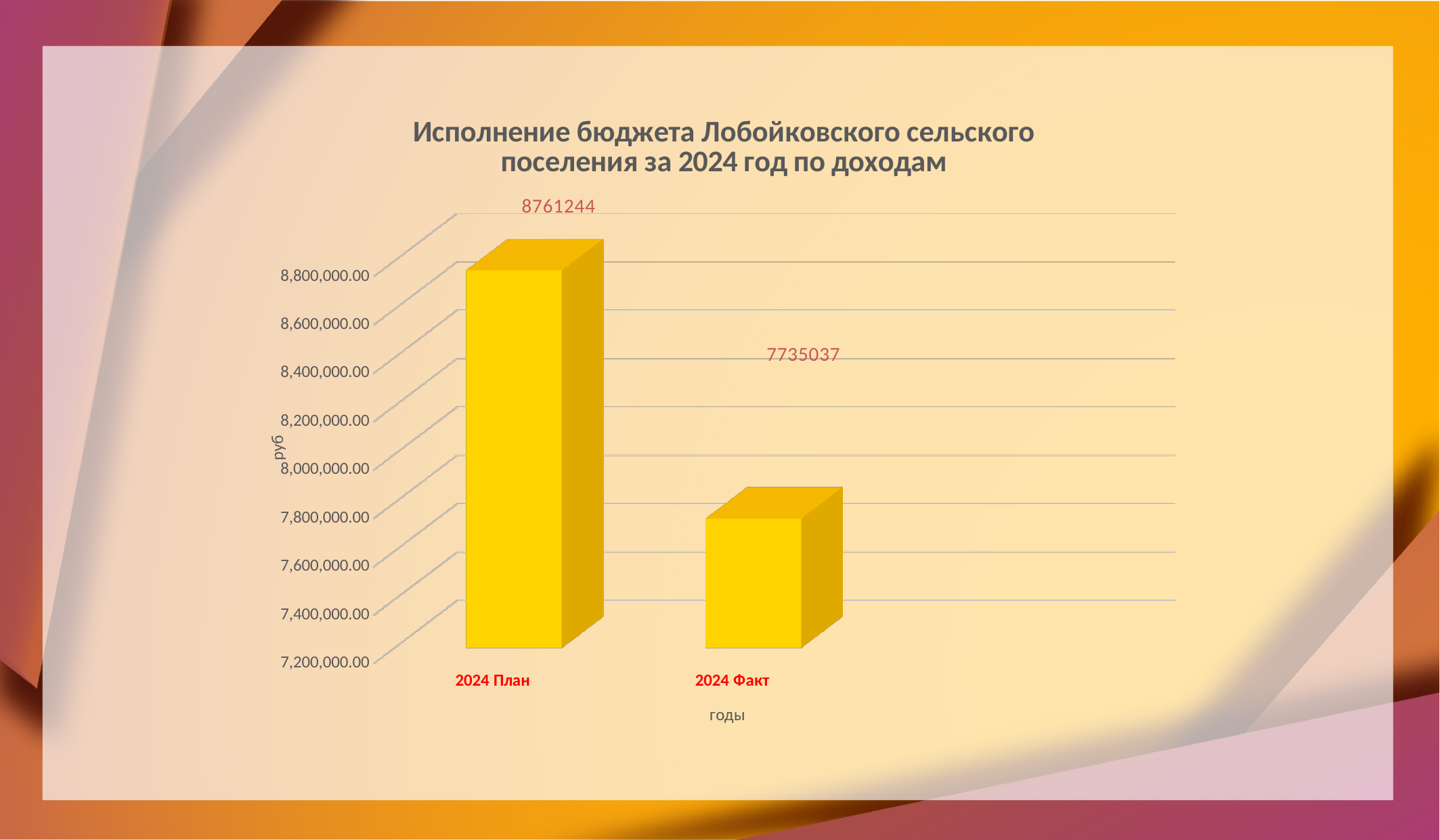
What is the value for 2024 Факт? 7735037 Is the value for 2024 Факт greater or less than 8,000,000.00? less What is the title of the chart? Исполнение бюджета Лобойковского сельского поселения за 2024 год по доходам What kind of chart is shown on the slide? bar chart How many categories are shown on the x axis? 2 Which is larger, the value for 2024 План or the value for 2024 Факт? 2024 План What is the value for 2024 План? 8761244 What is the difference between the values for 2024 План and 2024 Факт? 1026207 What is the label of the vertical axis? руб Which category has the lowest value? 2024 Факт Which category has the highest value? 2024 План Is the value for 2024 План greater or less than 8,600,000.00? greater